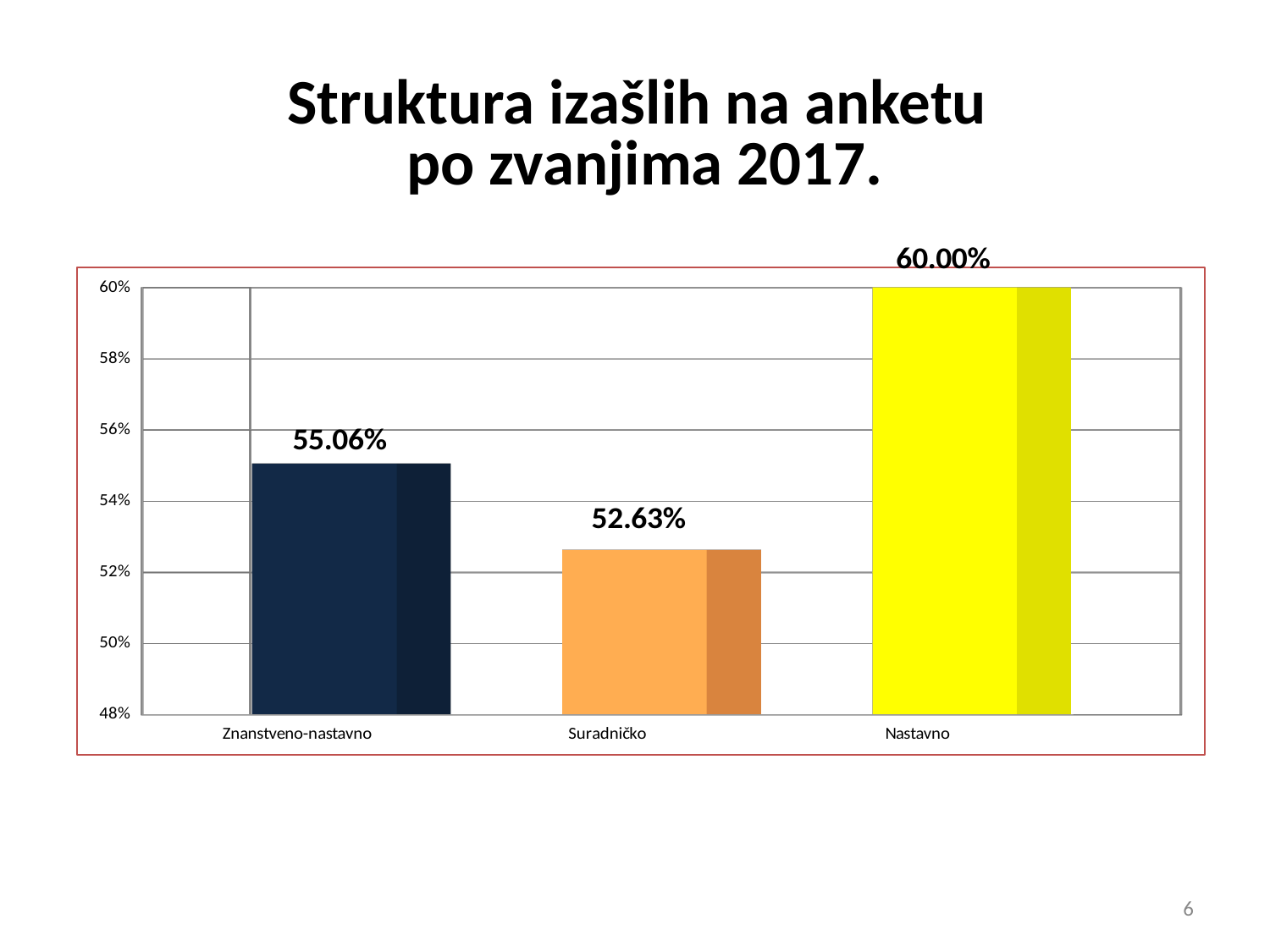
Which is larger, the value for Znanstveno-nastavno or the value for Suradničko? Znanstveno-nastavno What is the difference between the values for Znanstveno-nastavno and Suradničko? 2.43% What is the value for Nastavno? 60.00% What is the title of the slide? Struktura izašlih na anketu po zvanjima 2017. What is the value for Znanstveno-nastavno? 55.06% How many categories are shown on the chart? 3 Which category has the highest value? Nastavno What is the difference between the values for Nastavno and Suradničko? 7.37% What is the value for Suradničko? 52.63% Is the value for Suradničko greater or less than 54%? less Which category has the lowest value? Suradničko What kind of chart is shown on the slide? bar chart